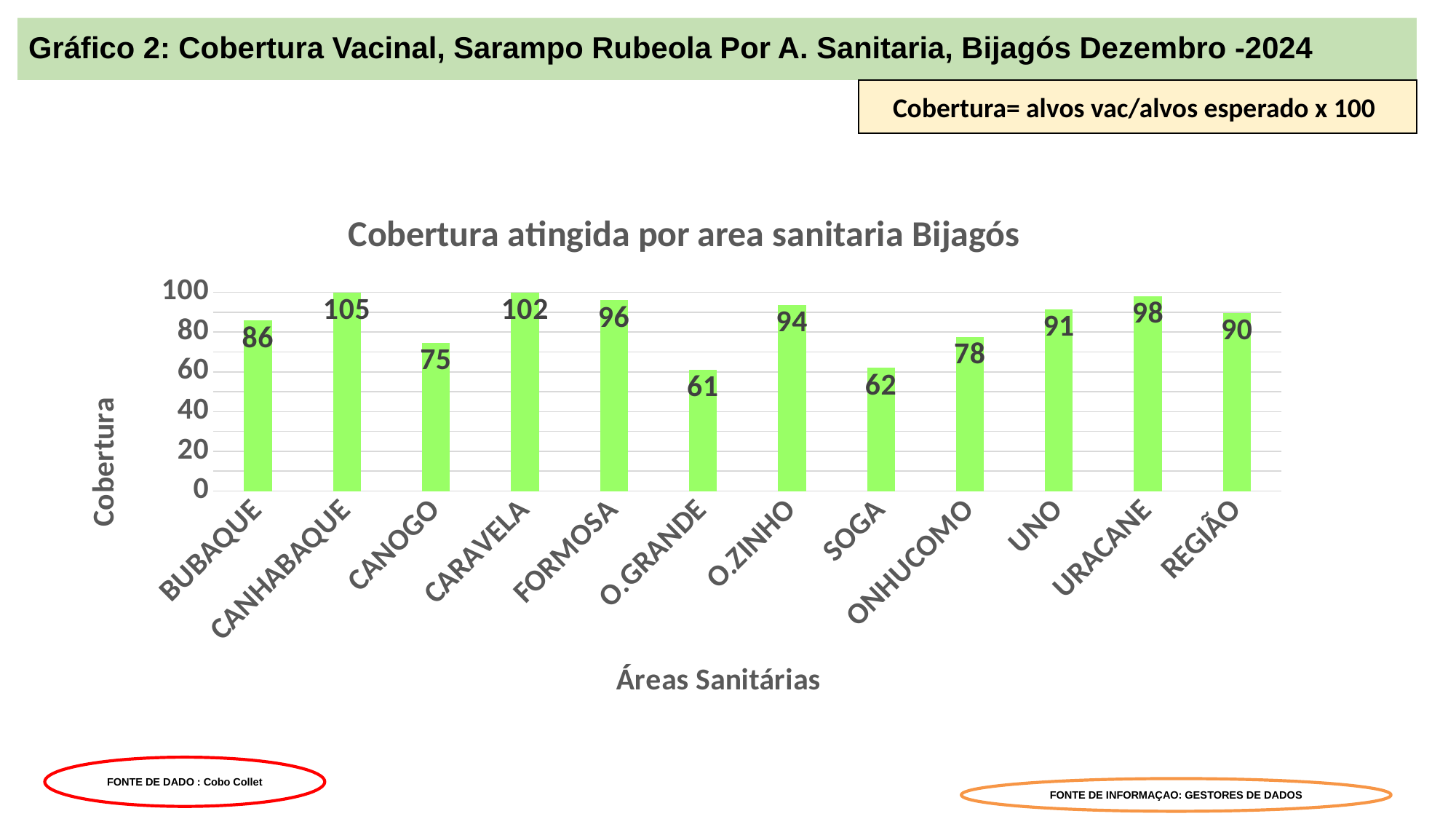
What kind of chart is shown on the slide? bar chart What is the value for REGIÃO? 90 What is the difference between the values for URACANE and CANOGO? 23 What is the x axis title of the chart? Áreas Sanitárias How many categories are shown on the x axis? 12 Which area has the highest coverage value? CANHABAQUE What is the value for CANHABAQUE? 105 What is the title of the chart? Cobertura atingida por area sanitaria Bijagós Is the value for ONHUCOMO greater or less than 60? greater Which is larger, the value for FORMOSA or the value for O.ZINHO? FORMOSA Which area has the lowest coverage value? O.GRANDE What is the value for O.GRANDE? 61